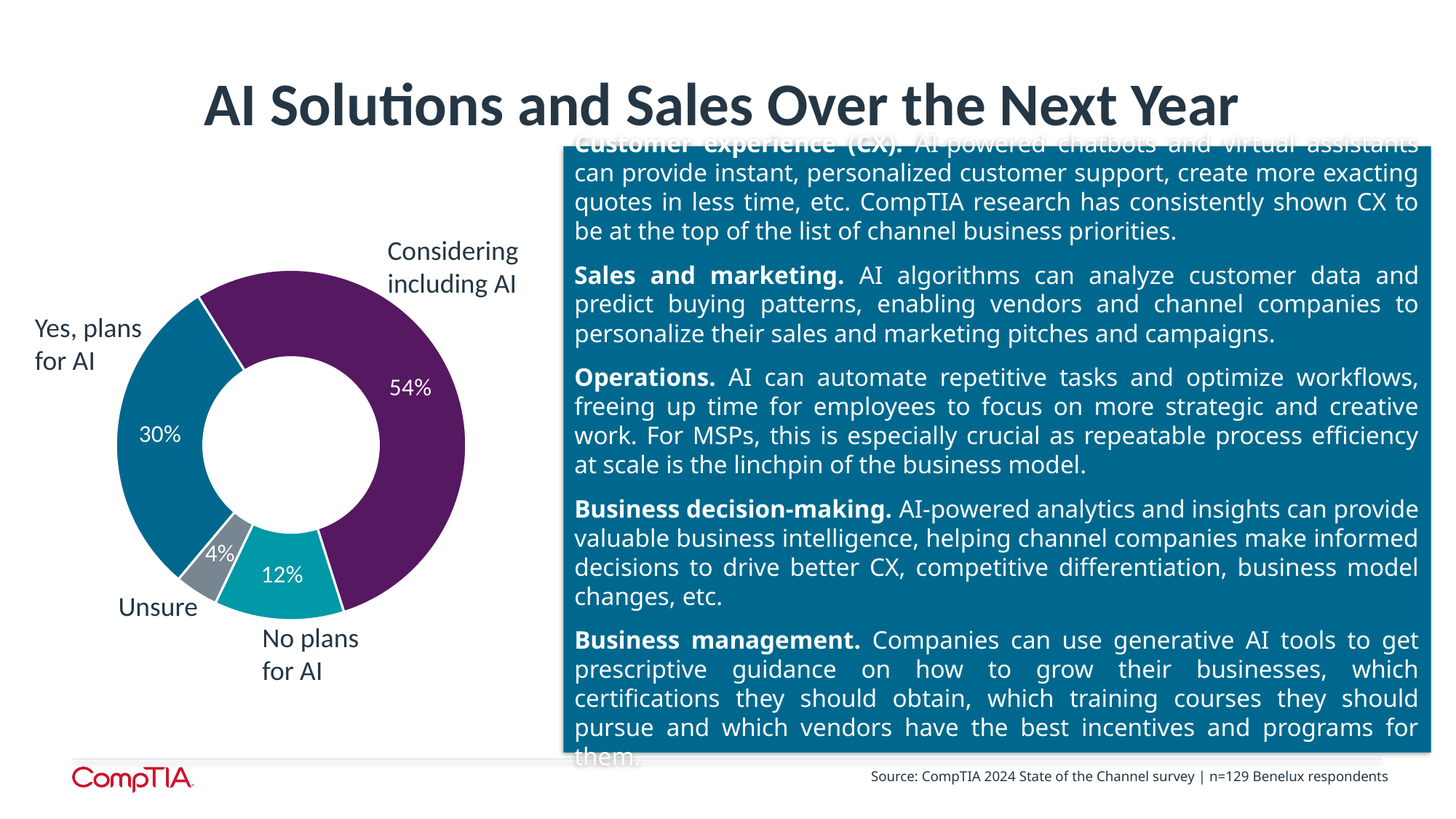
Which category has the largest share of the chart? Considering including AI What percentage of respondents have no plans for AI? 12% Which is larger: the share for 'No plans for AI' or the share for 'Unsure'? No plans for AI How many categories are shown in the chart? 4 What is the difference in percentage points between 'Considering including AI' and 'Yes, plans for AI'? 24 What percentage of respondents are unsure? 4% What colour is the 'Considering including AI' slice? Purple Which category has the smallest share of the chart? Unsure What percentage of respondents are considering including AI? 54% What kind of chart is shown on the slide? Doughnut (pie) chart What is the combined share of 'Yes, plans for AI' and 'No plans for AI'? 42% What percentage of respondents answered 'Yes, plans for AI'? 30%